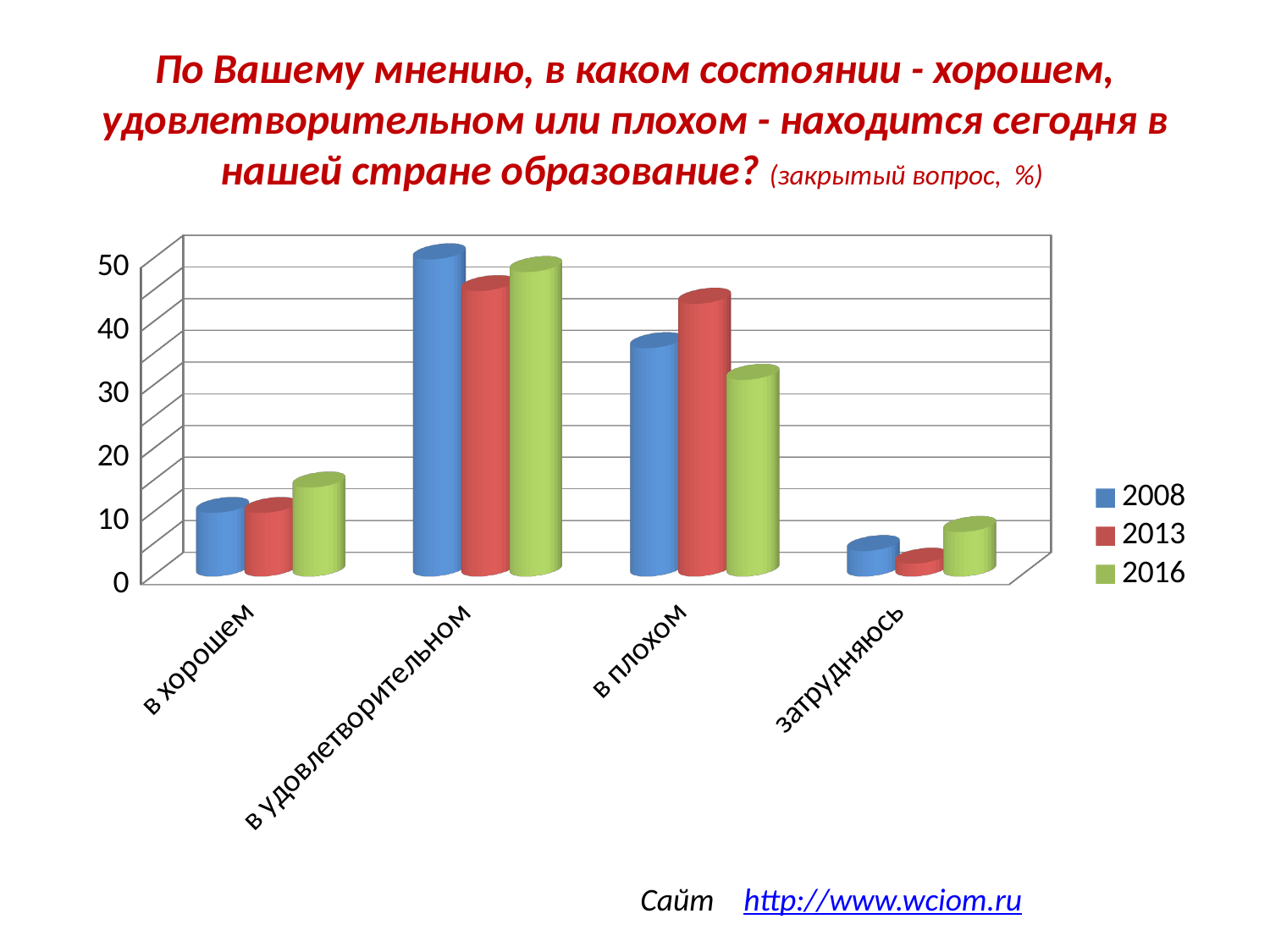
Which category has the highest value for 2016? в удовлетворительном For the category 'в хорошем', which year has the larger value, 2008 or 2016? 2016 For the category 'в плохом', which year has the larger value, 2013 or 2016? 2013 Which category has the lowest value for 2013? затрудняюсь Is the value for 'затрудняюсь' in 2013 greater or less than 10? less How many categories are shown on the x axis? 4 What kind of chart is shown on the slide? bar chart Is the value for 'в плохом' in 2016 greater or less than 20? greater Which year is shown in green in the legend? 2016 How many series does the legend list? 3 Which category has the highest value for 2008? в удовлетворительном Is the value for 'в удовлетворительном' in 2008 greater or less than 40? greater